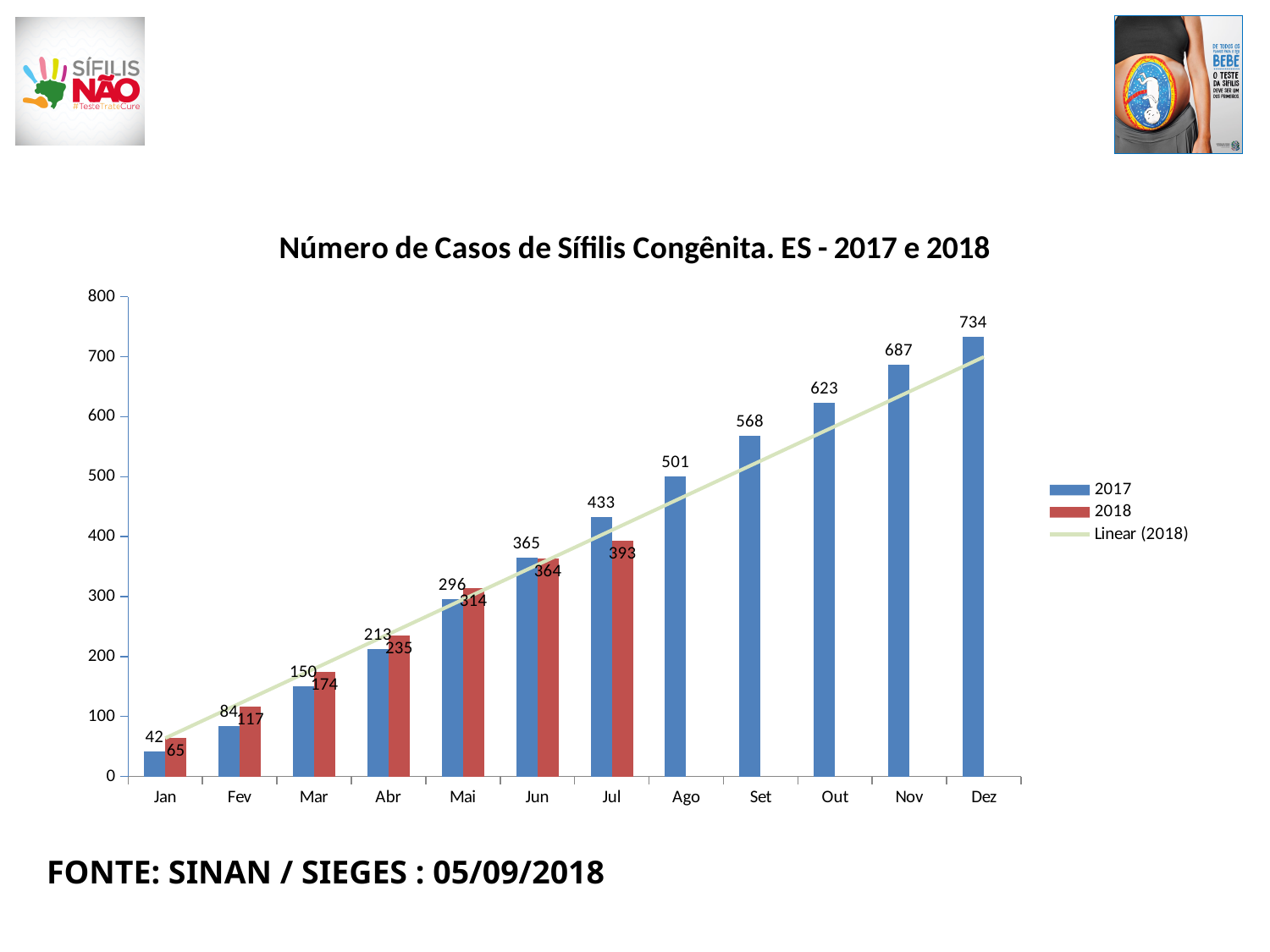
What is the value for 2017 in Jan? 42 What kind of chart is this? Bar chart Do the 2017 values rise or fall from Jan to Dez? Rise What is the value for 2018 in Jul? 393 What is the value for 2018 in Abr? 235 Which month has the highest value for the 2017 series? Dez Which is larger in Mai, the 2017 value or the 2018 value? 2018 How many series does the legend list? 3 Which month has the lowest value for the 2018 series? Jan How many months are shown on the x axis? 12 What is the value for 2017 in Dez? 734 What is the difference between the 2018 and 2017 values in Fev? 33